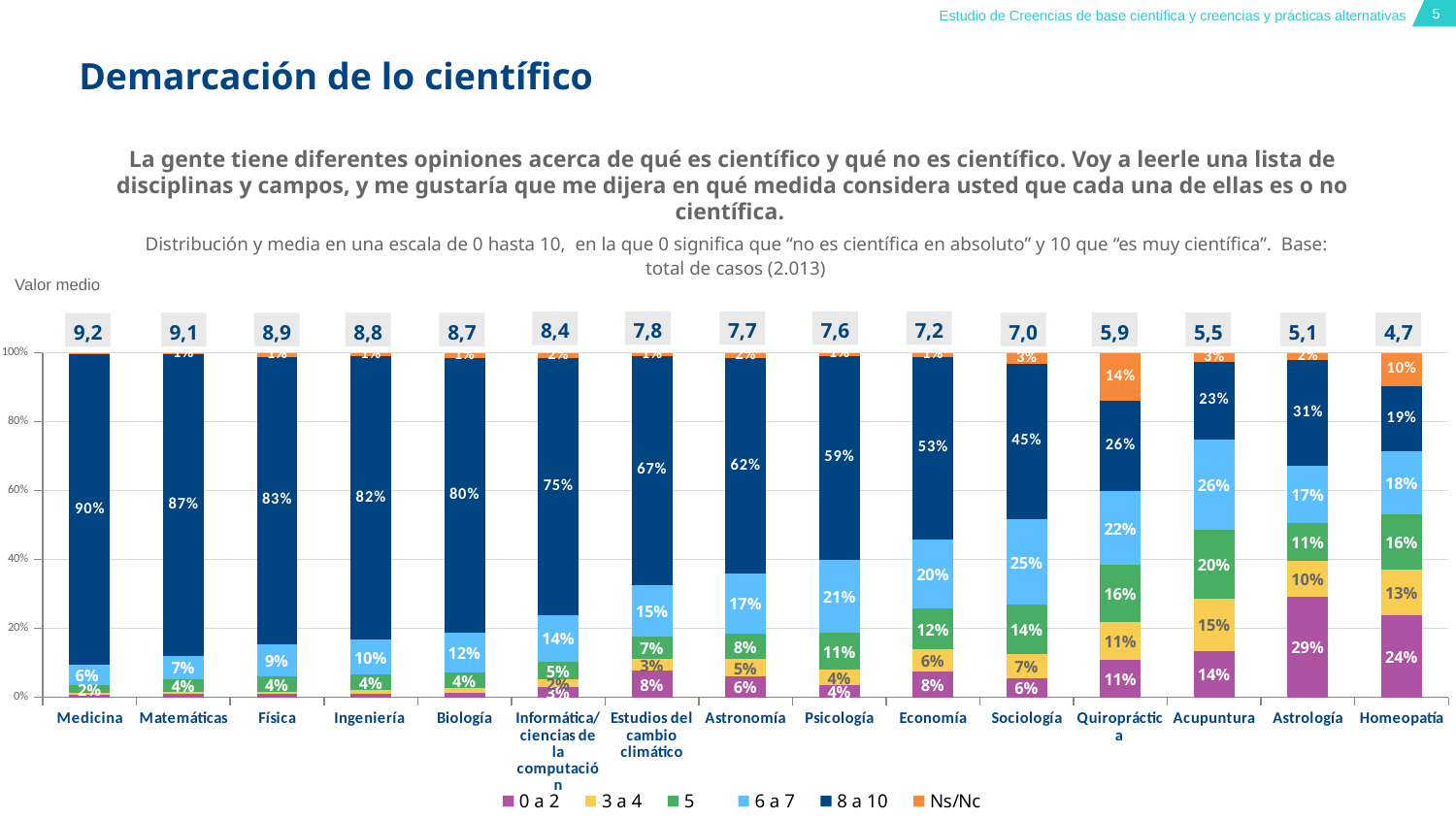
How many disciplines (categories) are shown along the x axis? 15 Which discipline has the highest '8 a 10' percentage? Medicina What is the Ns/Nc percentage for Quiropráctica? 14% What is the '0 a 2' percentage for Astrología? 29% How many series does the legend list? 6 What type of chart is shown on the slide? stacked bar chart What is the '8 a 10' percentage for Medicina? 90% What is the mean value (valor medio) shown above the bar for Física? 8,9 Which discipline has the lowest mean value (valor medio)? Homeopatía What is the difference between the '8 a 10' percentages for Matemáticas and Psicología? 28% Which has a larger '0 a 2' percentage, Acupuntura or Economía? Acupuntura What is the '8 a 10' percentage for Homeopatía? 19%